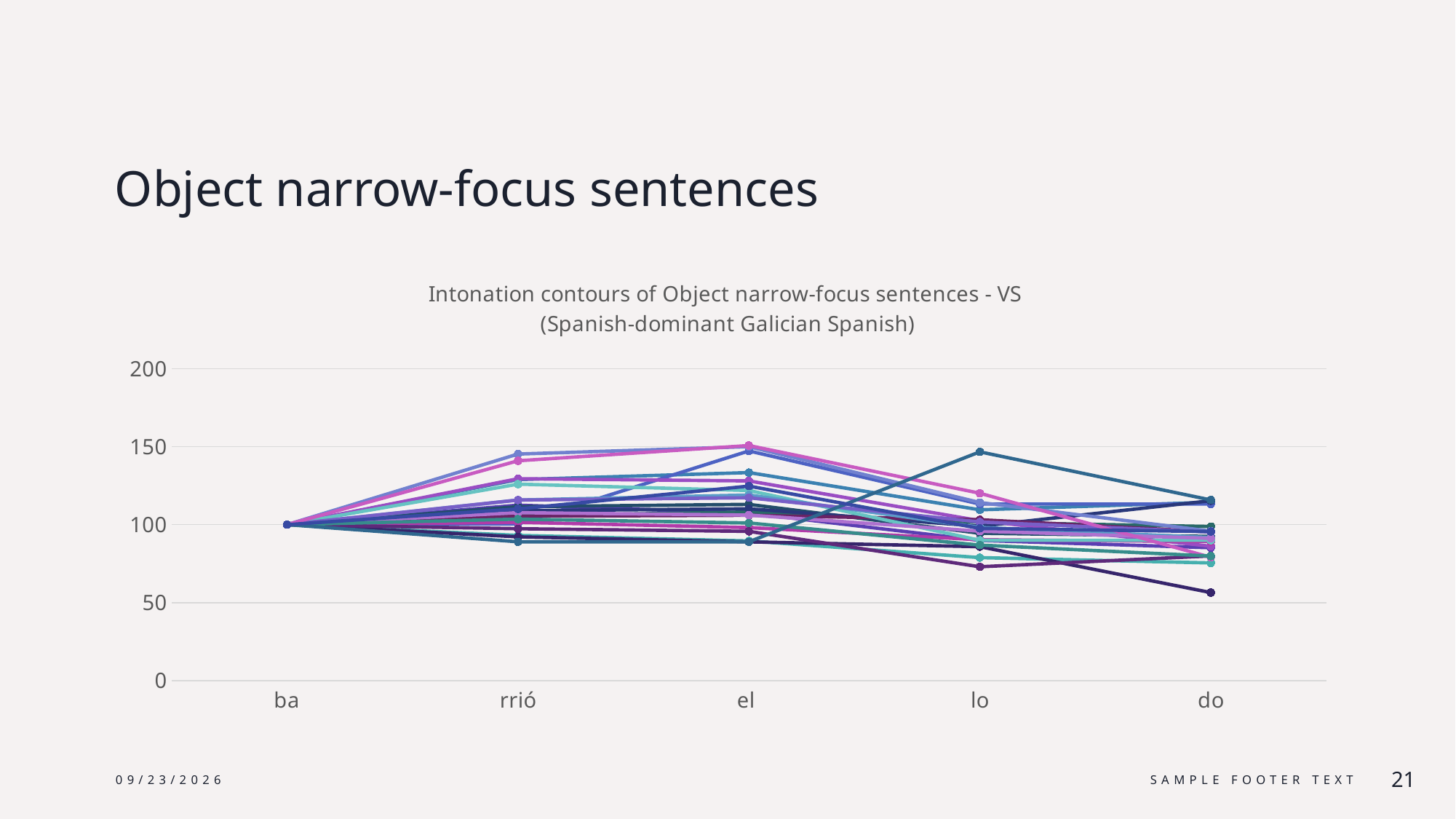
What kind of chart is shown on the slide? line chart Is the lowest value plotted at 'do' greater or less than 100? less Is the lowest value plotted at 'rrió' greater or less than 100? less What is the first category on the x axis? ba Is the lowest value plotted at 'do' greater or less than 50? greater What is the title of the chart? Intonation contours of Object narrow-focus sentences - VS (Spanish-dominant Galician Spanish) What is the highest tick value shown on the y axis? 200 What value do all the lines start at for the category 'ba'? 100 How many categories are on the x axis of the chart? 5 Which x-axis category contains the lowest plotted value in the chart? do